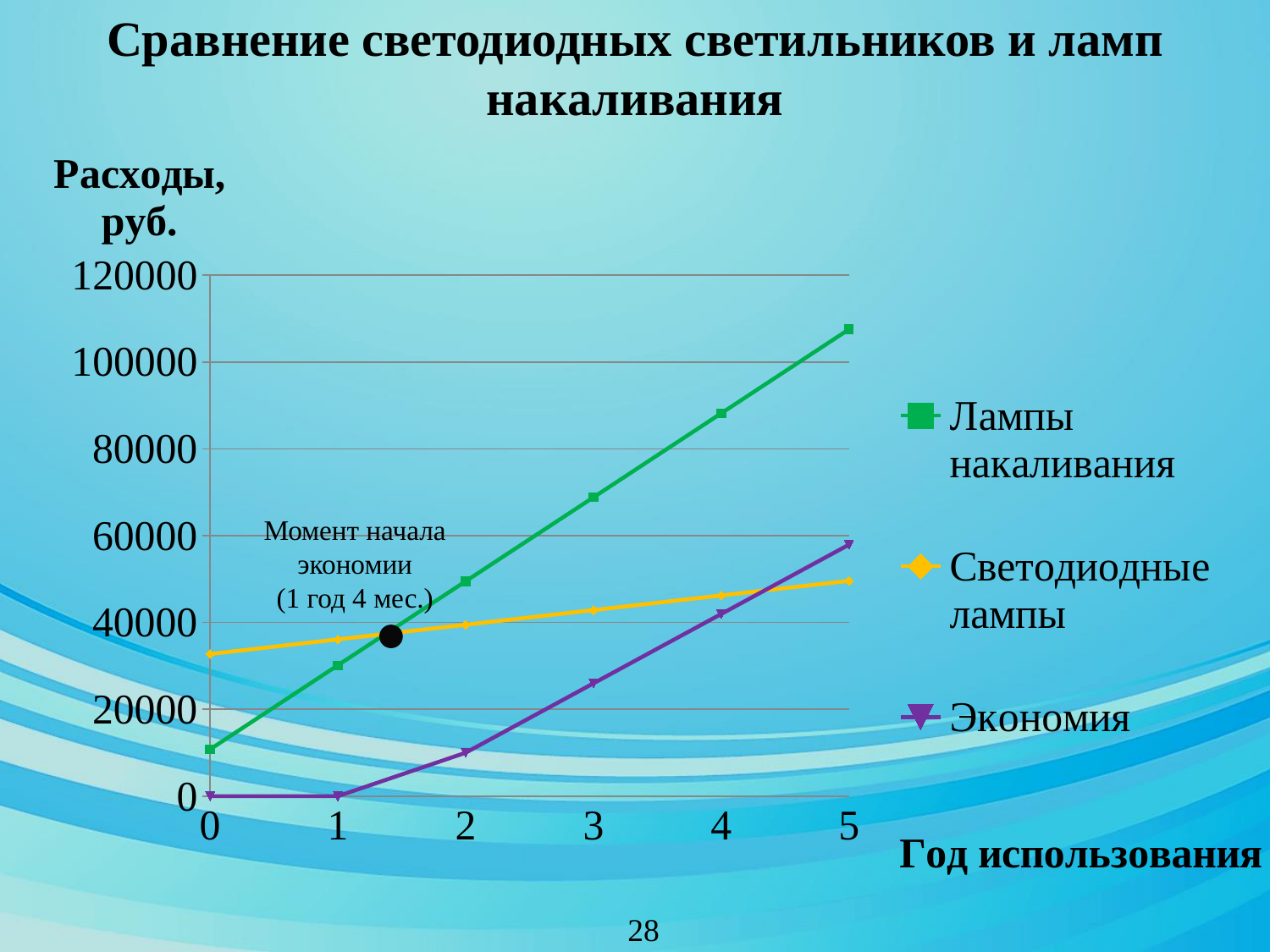
Do the values for Лампы накаливания rise or fall as the year of use increases? rise How many points along the x axis (years of use) are plotted for each series? 6 What is the value of Экономия at year 1? 0 Is the value for Лампы накаливания at year 5 greater or less than 100000? greater According to the annotation on the chart, when does the saving begin (Момент начала экономии)? 1 год 4 мес. Is the value for Светодиодные лампы at year 5 greater or less than 60000? less What kind of chart is shown on the slide? line chart At year 1, which is larger: Лампы накаливания or Светодиодные лампы? Светодиодные лампы What is the value of Экономия at year 0? 0 Which series has the highest value at year 5? Лампы накаливания Which series has the lowest value at year 2? Экономия How many series does the legend list? 3